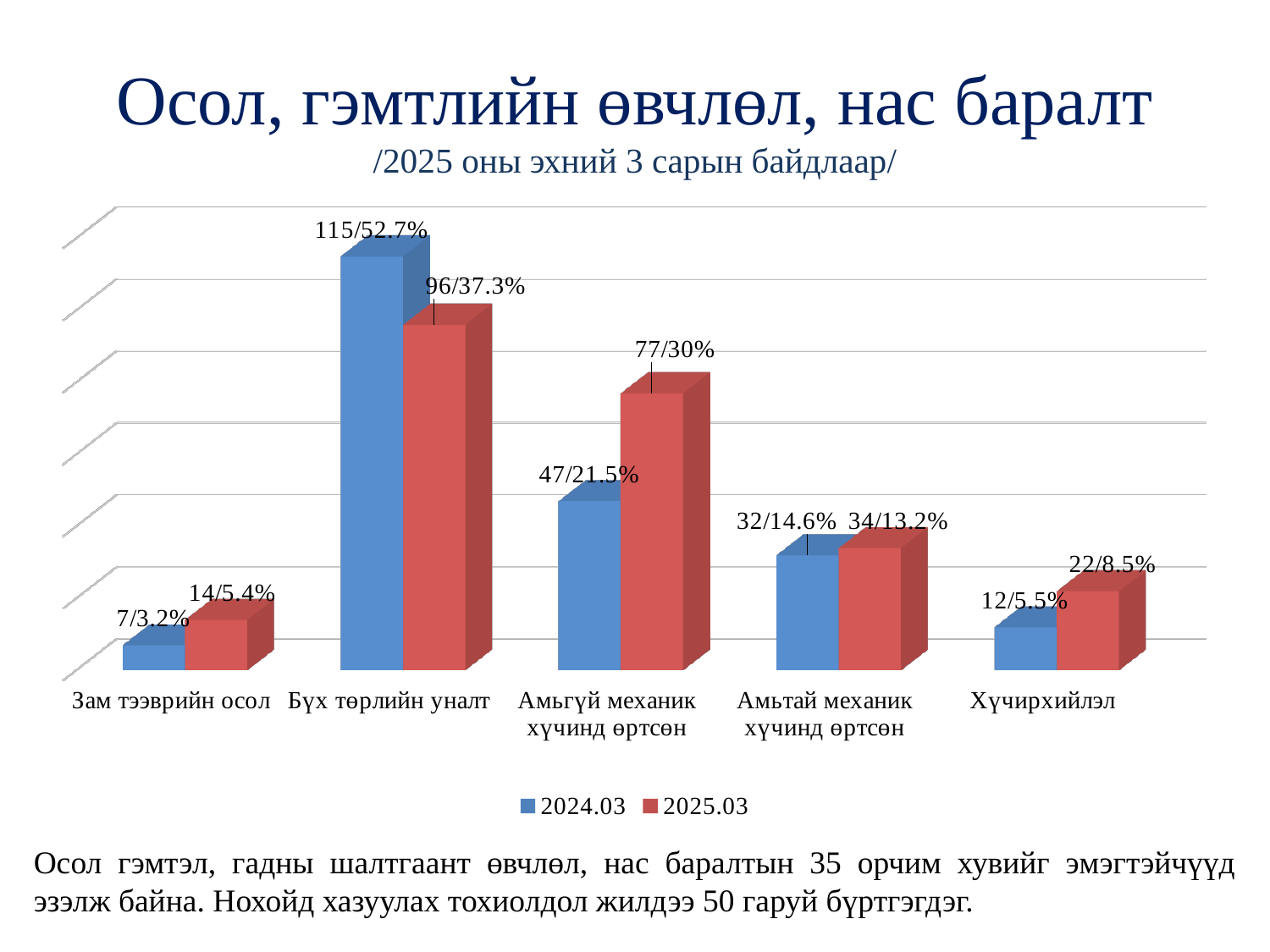
What kind of chart is shown on the slide? Bar chart What is the data label for Амьгүй механик хүчинд өртсөн in the 2025.03 series? 77/30% Which series is shown in red in the legend? 2025.03 Which category has the lowest value in the 2024.03 series? Зам тээврийн осол What is the data label for Бүх төрлийн уналт in the 2024.03 series? 115/52.7% Which is larger for Амьгүй механик хүчинд өртсөн: the 2024.03 value or the 2025.03 value? 2025.03 How many categories are shown on the x axis? 5 What is the data label for Хүчирхийлэл in the 2024.03 series? 12/5.5% Which category has the highest value in the 2025.03 series? Бүх төрлийн уналт By how many cases did Бүх төрлийн уналт decrease from 2024.03 to 2025.03? 19 How many series does the legend list? 2 What is the data label for Зам тээврийн осол in the 2025.03 series? 14/5.4%